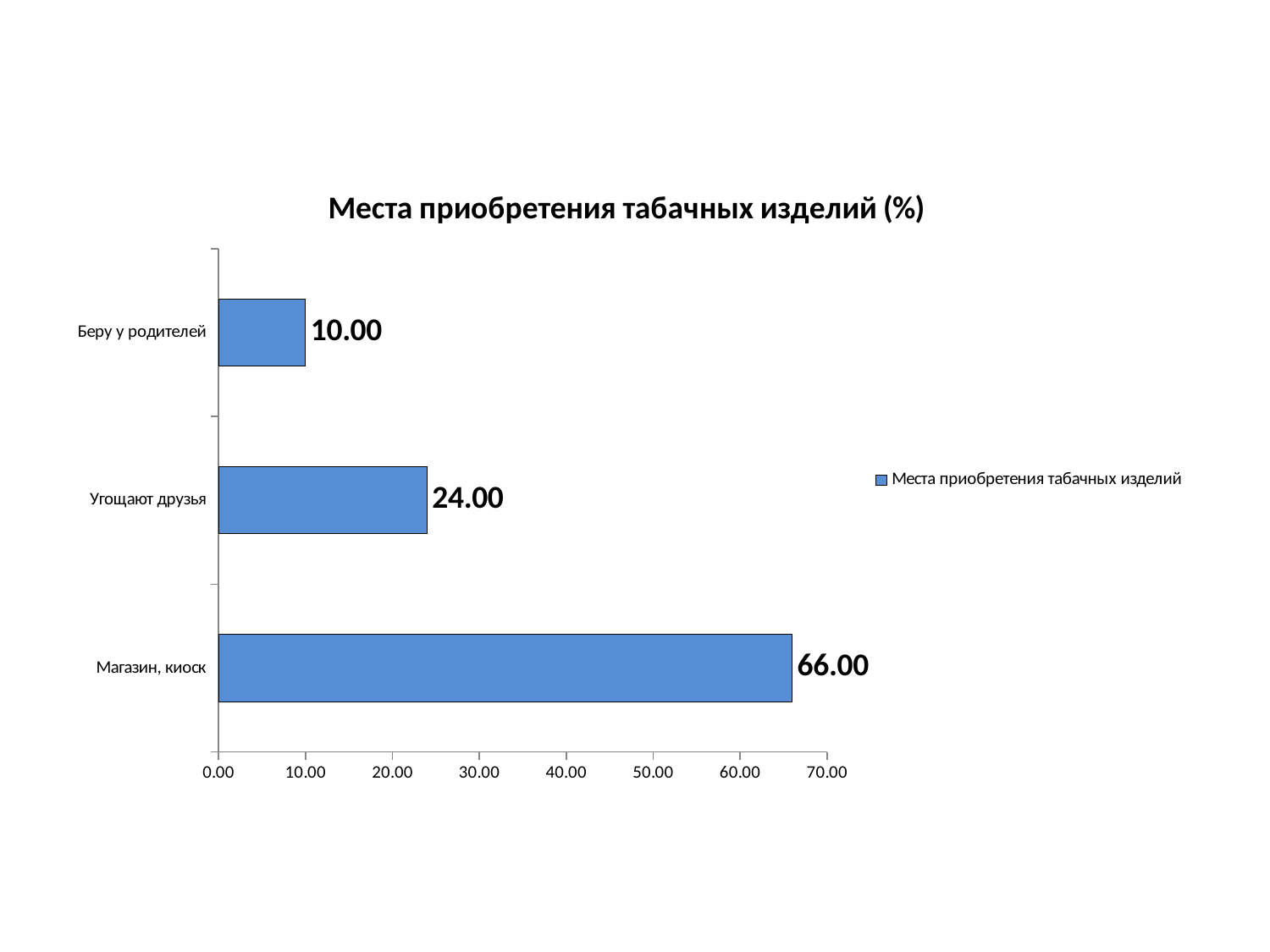
Which is larger, the value for Угощают друзья or the value for Беру у родителей? Угощают друзья What kind of chart is shown on the slide? bar chart How many categories are shown in the chart? 3 What is the difference between the values for Угощают друзья and Беру у родителей? 14.00 Which category has the lowest value? Беру у родителей What is the title of the chart? Места приобретения табачных изделий (%) What is the difference between the values for Магазин, киоск and Угощают друзья? 42.00 What is the value for Беру у родителей? 10.00 What is the value for Магазин, киоск? 66.00 What is the value for Угощают друзья? 24.00 Is the value for Магазин, киоск greater or less than 60.00? greater Which category has the highest value? Магазин, киоск